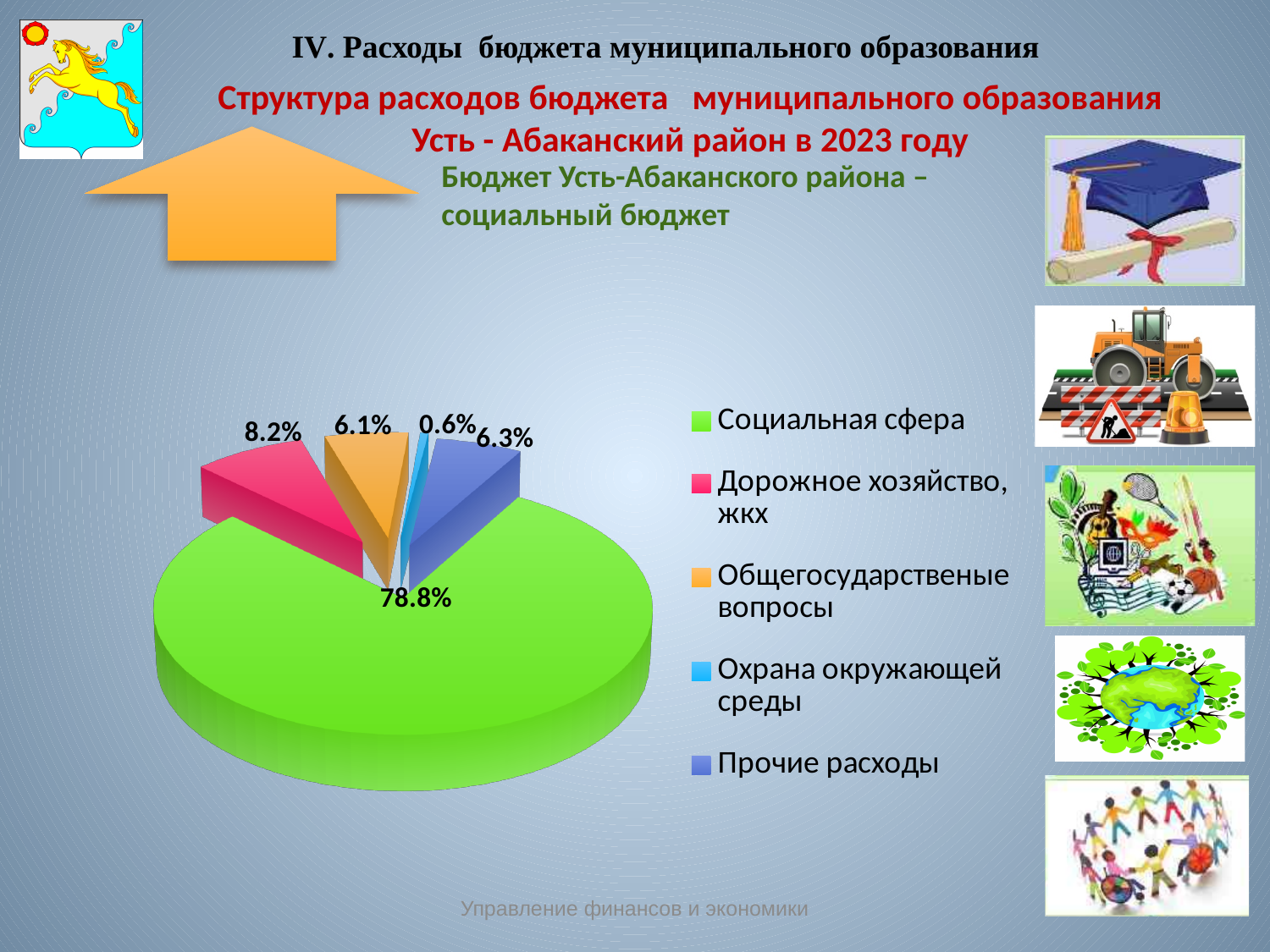
Which category has the smallest slice of the pie? Охрана окружающей среды What share of the pie does Социальная сфера account for? 78.8% Which category has the largest slice of the pie? Социальная сфера What is the value shown for Прочие расходы? 6.3% What colour is the slice for Социальная сфера? Green What is the difference between the shares of Социальная сфера and Дорожное хозяйство, жкх? 70.6% What is the value shown for Охрана окружающей среды? 0.6% What is the value shown for Общегосударственые вопросы? 6.1% What is the value shown for Дорожное хозяйство, жкх? 8.2% How many categories does the pie chart show? 5 Which is larger, the share for Прочие расходы or the share for Общегосударственые вопросы? Прочие расходы What type of chart is shown on the slide? Pie chart